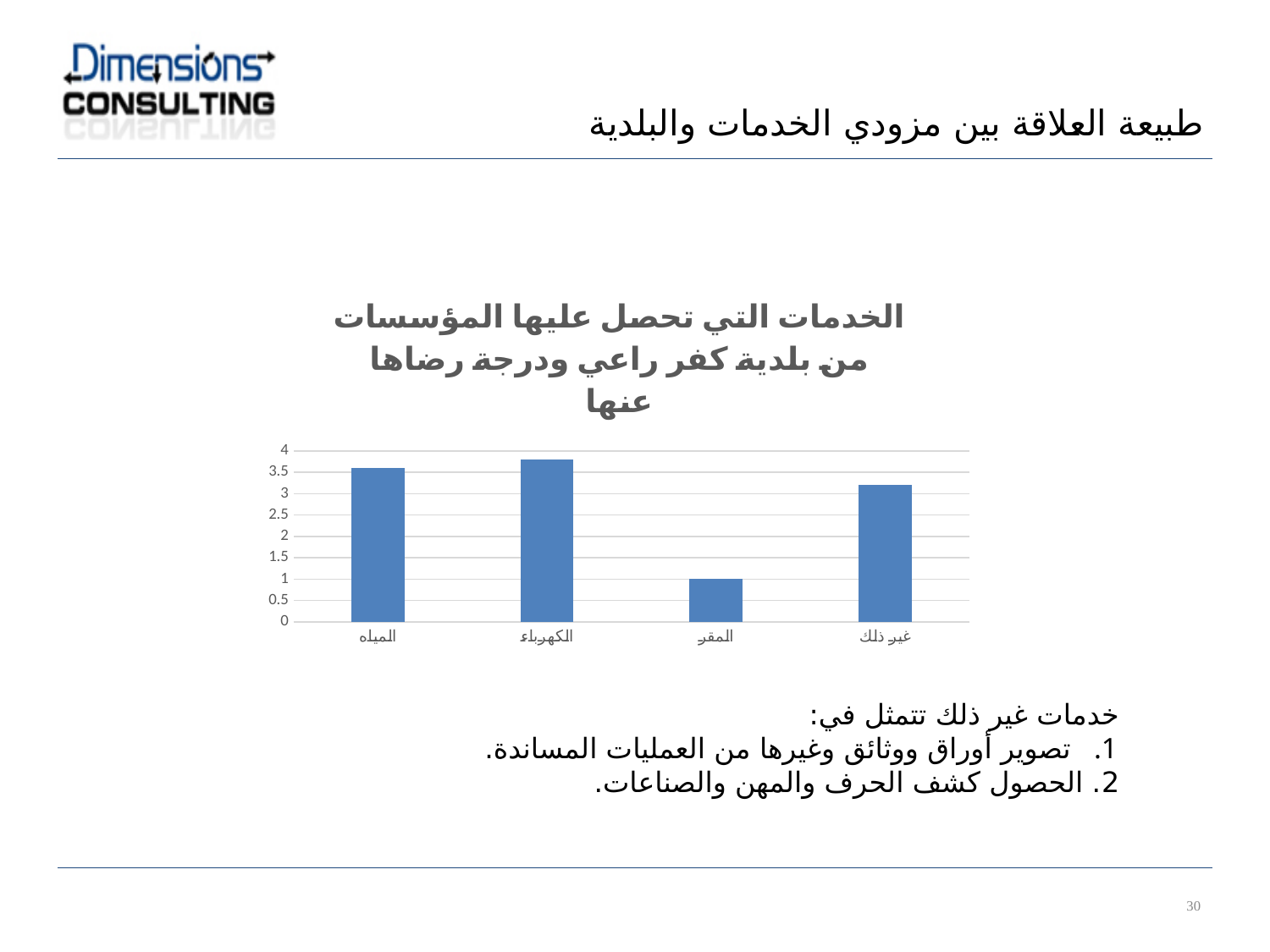
Is the value for الكهرباء greater or less than 3.5? greater What type of chart is shown on the slide? Bar chart What is the value for المقر in the chart? 1 Is the value for المقر greater or less than 2? less Which is larger, the value for المياه or the value for غير ذلك? المياه What colour are the bars in the chart? Blue Which category has the lowest bar in the chart? المقر Which category has the highest bar in the chart? الكهرباء Is the value for غير ذلك greater or less than 3.5? less What is the title of the chart? الخدمات التي تحصل عليها المؤسسات من بلدية كفر راعي ودرجة رضاها عنها How many categories are shown on the x axis of the chart? 4